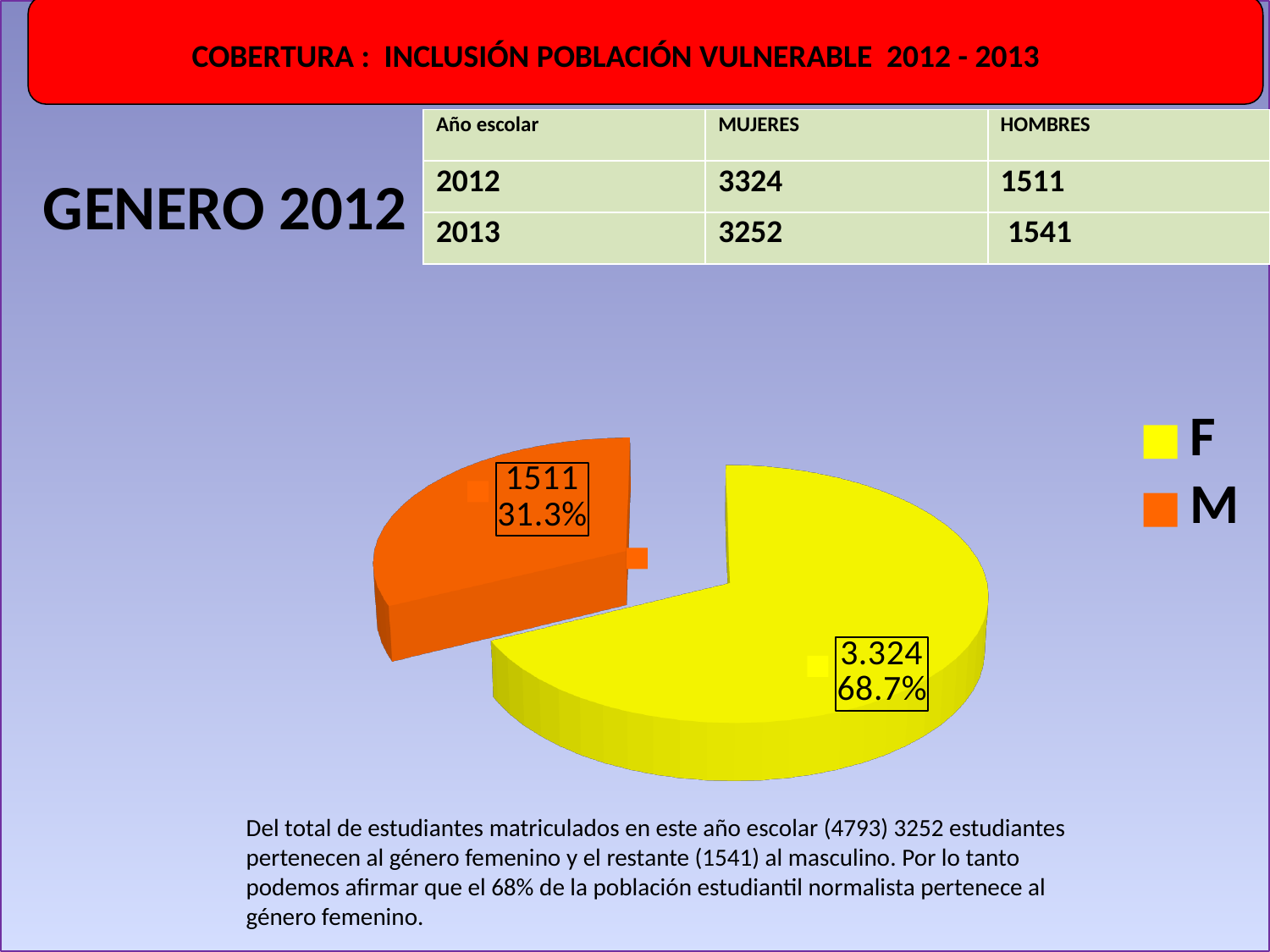
How many entries does the legend of the pie chart list? 2 What percentage share of the pie does the F slice represent? 68.7% Which slice of the pie chart is the largest? F Which is larger in the pie chart, F or M? F What percentage share of the pie does the M slice represent? 31.3% What kind of chart is shown on the slide? pie chart What colour is the F slice in the pie chart? yellow What value is shown for the M slice of the pie chart? 1511 Which slice of the pie chart is the smallest? M What colour is the M slice in the pie chart? orange What value is shown for the F slice of the pie chart? 3.324 How many slices does the pie chart have? 2